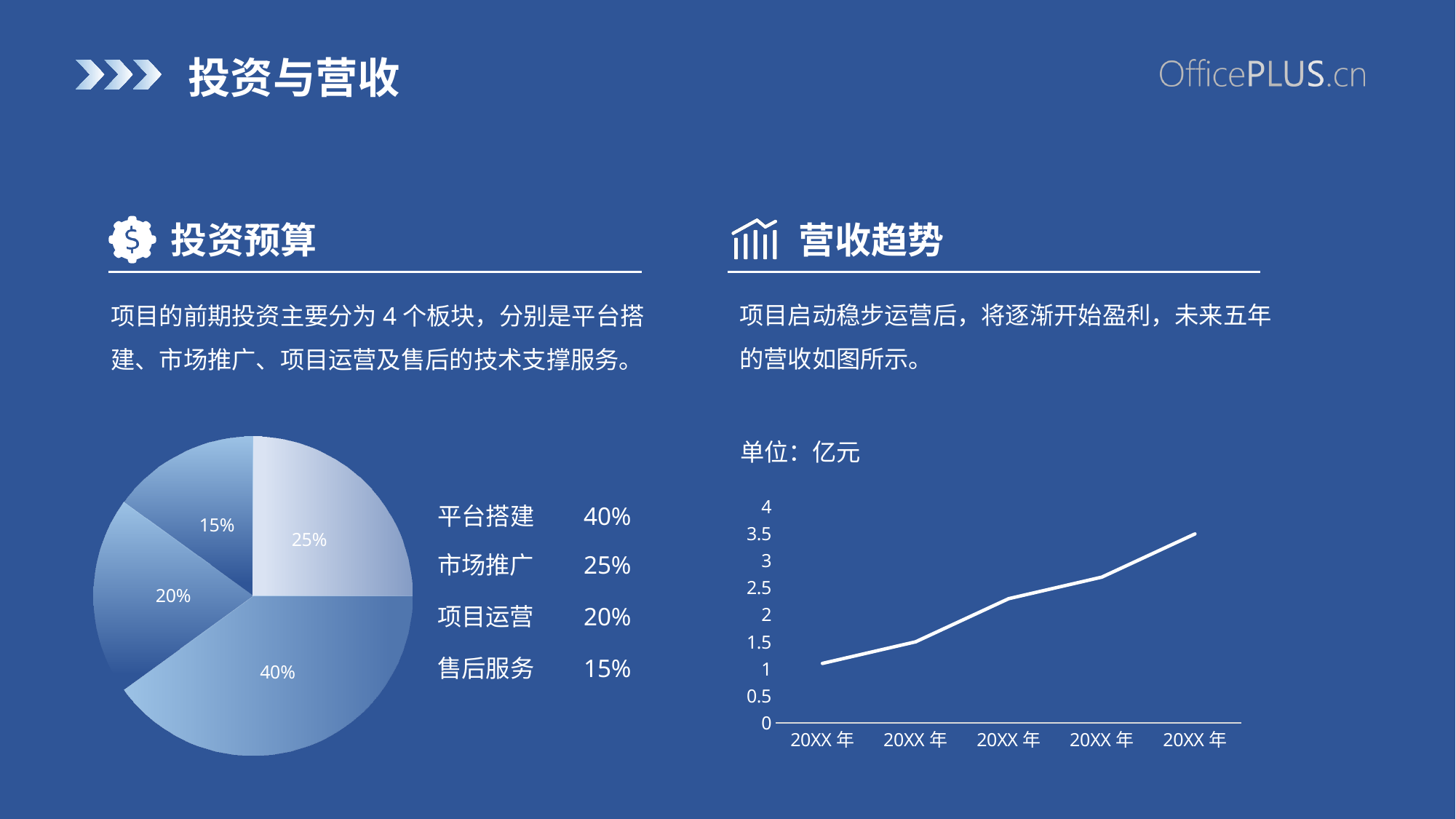
On the pie chart titled 投资预算, what share does 市场推广 account for? 25% On the pie chart titled 投资预算, which is larger, 市场推广 or 项目运营? 市场推广 What unit is stated for the line chart titled 营收趋势? 亿元 What kind of chart is used under the heading 营收趋势 on the right of the slide? line chart On the line chart titled 营收趋势, do the values rise or fall from left to right along the x axis? rise On the pie chart titled 投资预算, which category has the smallest share? 售后服务 On the pie chart titled 投资预算, which category has the largest share? 平台搭建 How many categories does the pie chart titled 投资预算 show? 4 On the pie chart titled 投资预算, what share does 售后服务 account for? 15% On the line chart titled 营收趋势, is the value for the last year greater or less than 3? greater On the pie chart titled 投资预算, what is the difference in percentage points between 平台搭建 and 项目运营? 20 On the pie chart titled 投资预算, what share does 平台搭建 account for? 40%